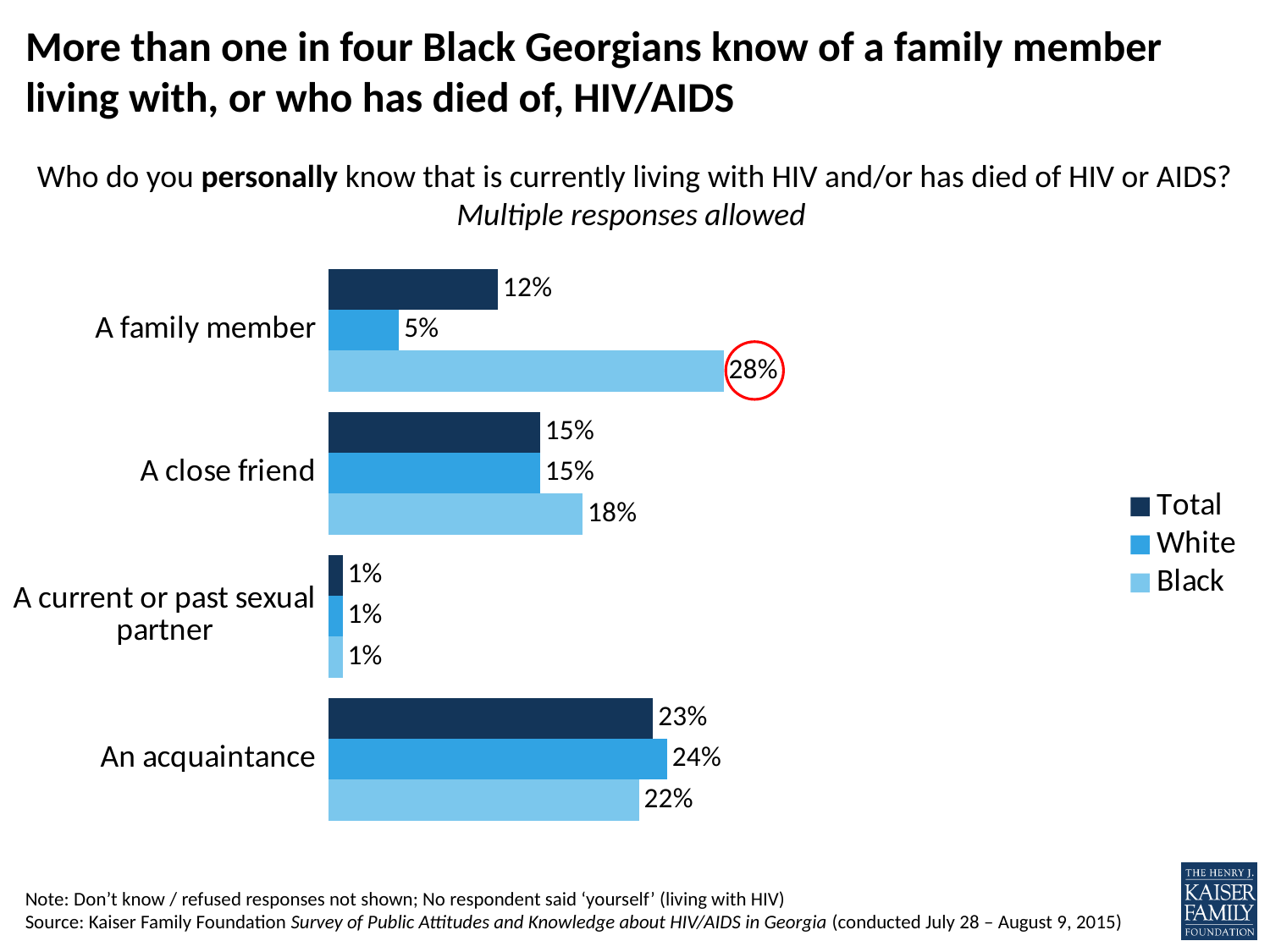
What is the Total value for 'An acquaintance'? 23% What is the value for Black respondents for 'A close friend'? 18% Which category has the highest value for Black respondents? A family member For 'An acquaintance', which is larger: the White value or the Black value? White What kind of chart is shown on the slide? Bar chart How many series does the legend list? 3 Which category has the lowest value for the Total series? A current or past sexual partner What is the value for White respondents for 'A family member'? 5% What percentage of Black respondents say they personally know a family member living with or who has died of HIV/AIDS? 28% What is the difference between the Black and White values for 'A family member'? 23 percentage points How many response categories are shown on the chart? 4 Which series is shown in the darkest blue colour? Total